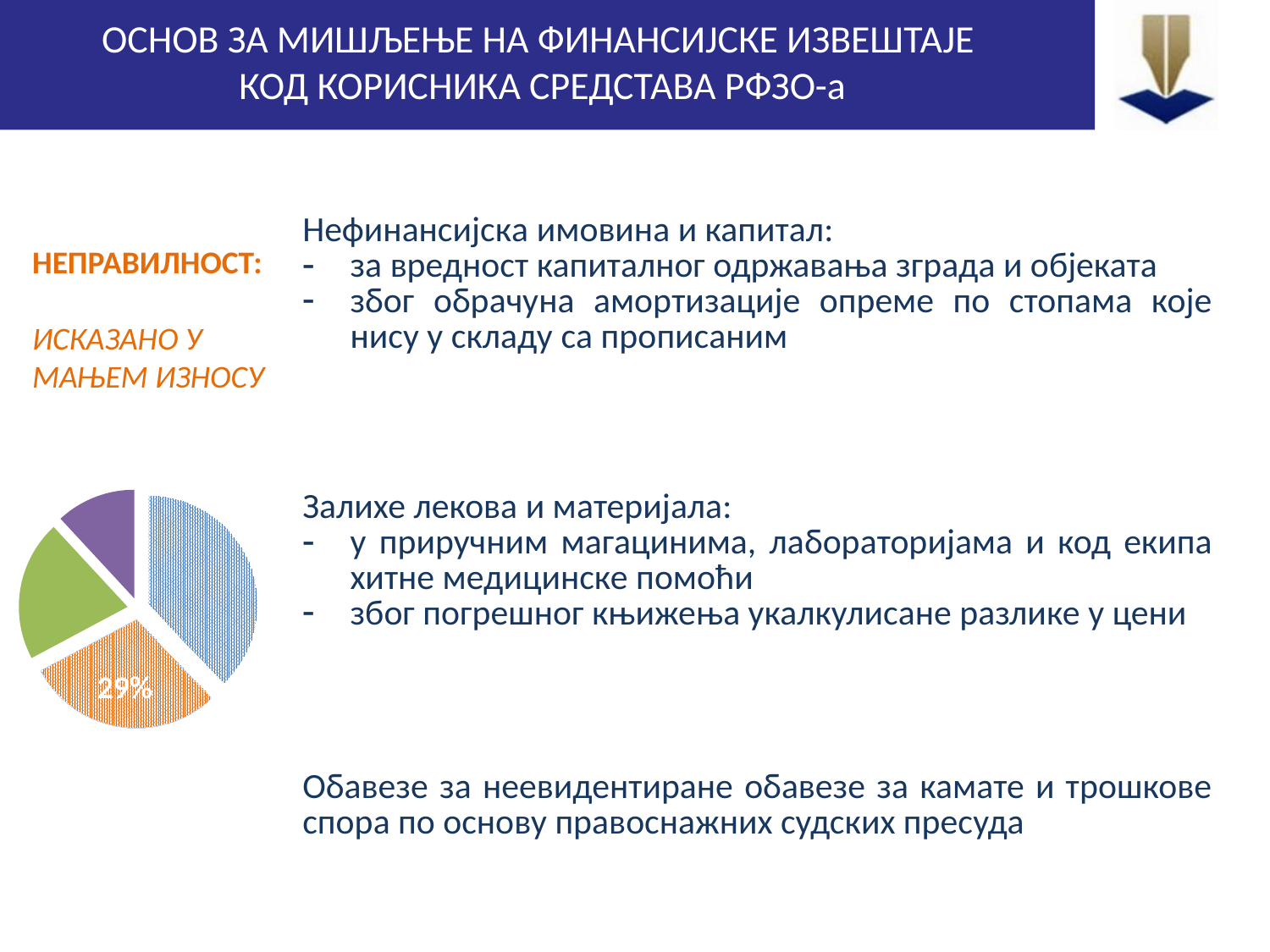
What percentage is printed on the orange slice of the pie chart? 29% Which is larger in the pie chart, the green slice or the purple slice? green What kind of chart is shown on the slide? pie chart Which colour slice of the pie chart is the smallest? purple What colour is the slice of the pie chart labelled 29%? orange How many slices does the pie chart have? 4 How many slices of the pie chart have a percentage label printed on them? 1 Which colour slice of the pie chart is the largest? blue Which is larger in the pie chart, the blue slice or the orange slice? blue